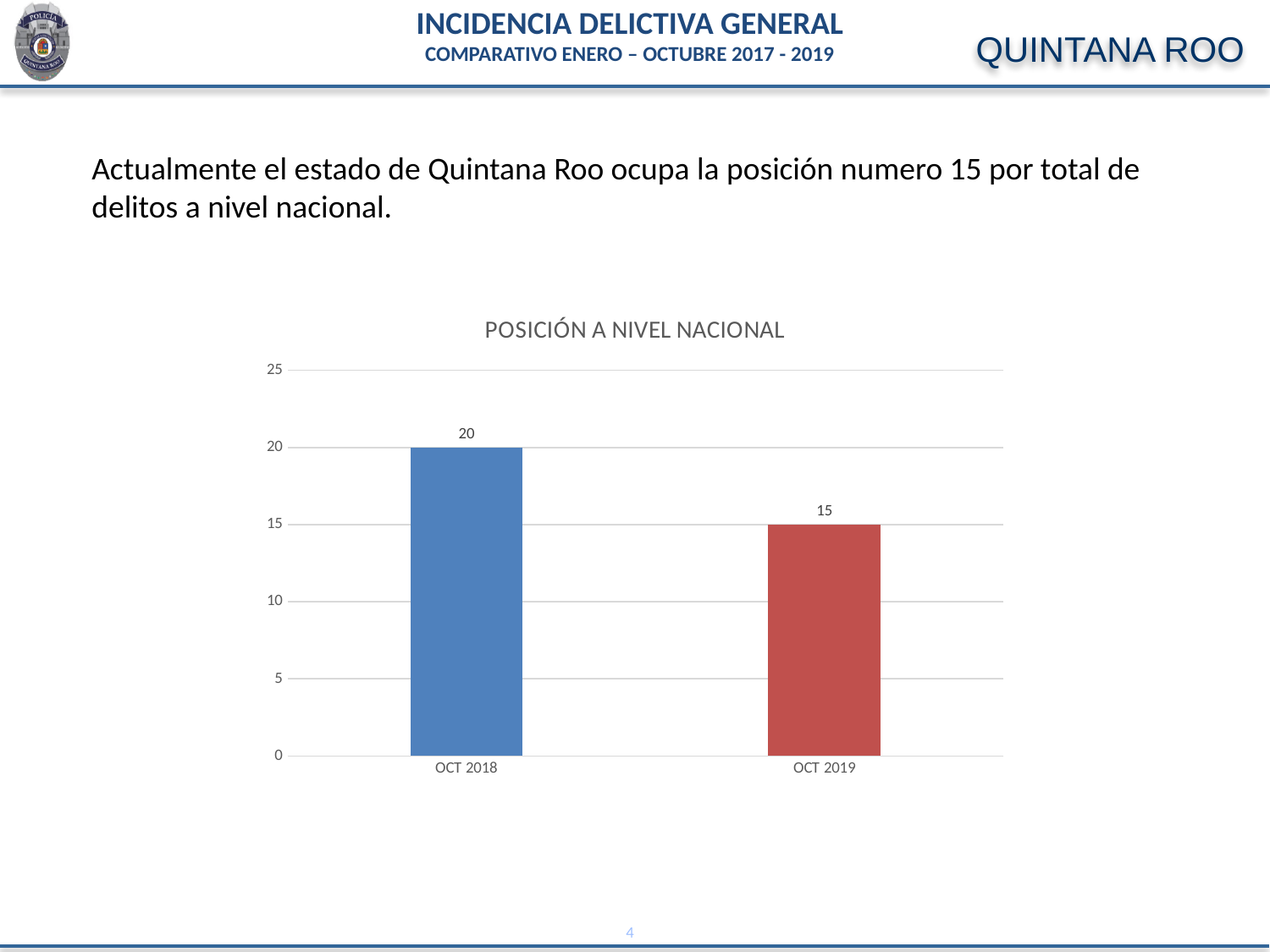
What kind of chart is shown on the slide? bar chart What is the value for OCT 2019 in the chart? 15 How many categories are shown on the x axis of the chart? 2 Which is larger, the value for OCT 2018 or the value for OCT 2019? OCT 2018 Which category has the lowest value in the chart? OCT 2019 What is the difference between the values for OCT 2018 and OCT 2019? 5 What colour is the bar for OCT 2019? red What is the value for OCT 2018 in the chart? 20 Do the values rise or fall from OCT 2018 to OCT 2019? fall Which category has the highest value in the chart? OCT 2018 What is the title of the chart? POSICIÓN A NIVEL NACIONAL Is the value for OCT 2019 greater or less than 20? less